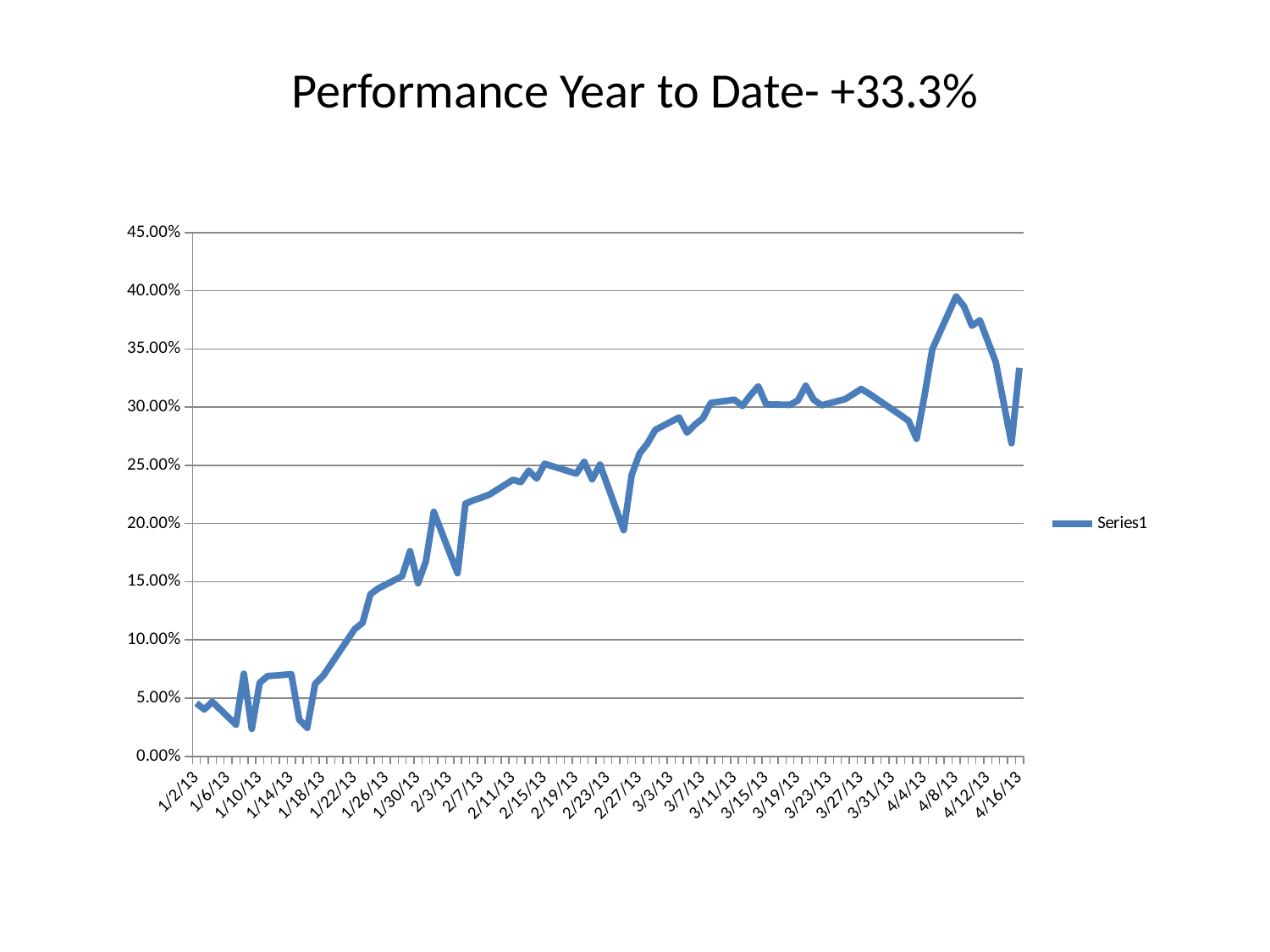
Is the value for 1/2/13 greater or less than 10.00%? less What kind of chart is shown on the slide? line chart Is the value for 4/8/13 greater or less than 35.00%? greater Is the value for 4/16/13 greater or less than 30.00%? greater Overall, does the line rise or fall from 1/2/13 to 4/16/13? rise What is the title of the chart? Performance Year to Date- +33.3% What is the name of the series shown in the legend? Series1 Which is larger, the value for 4/8/13 or the value for 1/2/13? 4/8/13 How many series does the legend list? 1